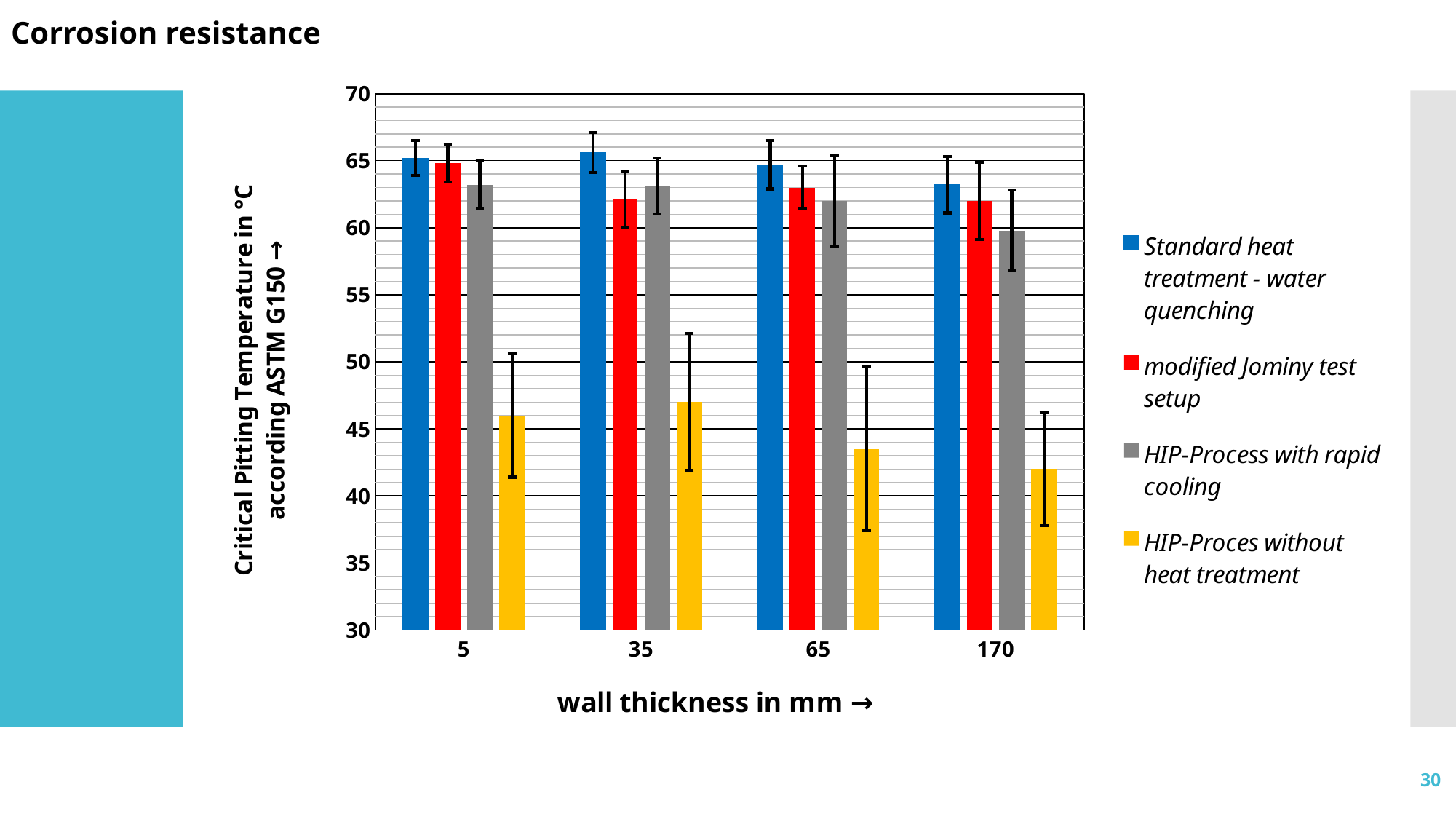
At a wall thickness of 170 mm, which is larger: modified Jominy test setup or HIP-Process with rapid cooling? modified Jominy test setup How many wall thickness categories are shown on the x axis? 4 What type of chart is shown on the slide? bar chart Does the value for HIP-Process with rapid cooling rise or fall from 5 mm to 170 mm wall thickness? fall Is the value for HIP-Proces without heat treatment at 170 mm greater or less than 45? less Is the value for HIP-Proces without heat treatment at 35 mm greater or less than 45? greater How many series does the legend list? 4 What is the x-axis title of the chart? wall thickness in mm Which series has the highest Critical Pitting Temperature at a wall thickness of 170 mm? Standard heat treatment - water quenching Is the value for Standard heat treatment - water quenching at 5 mm greater or less than 60? greater Which series has the lowest Critical Pitting Temperature at a wall thickness of 5 mm? HIP-Proces without heat treatment At a wall thickness of 65 mm, which is larger: Standard heat treatment - water quenching or HIP-Proces without heat treatment? Standard heat treatment - water quenching